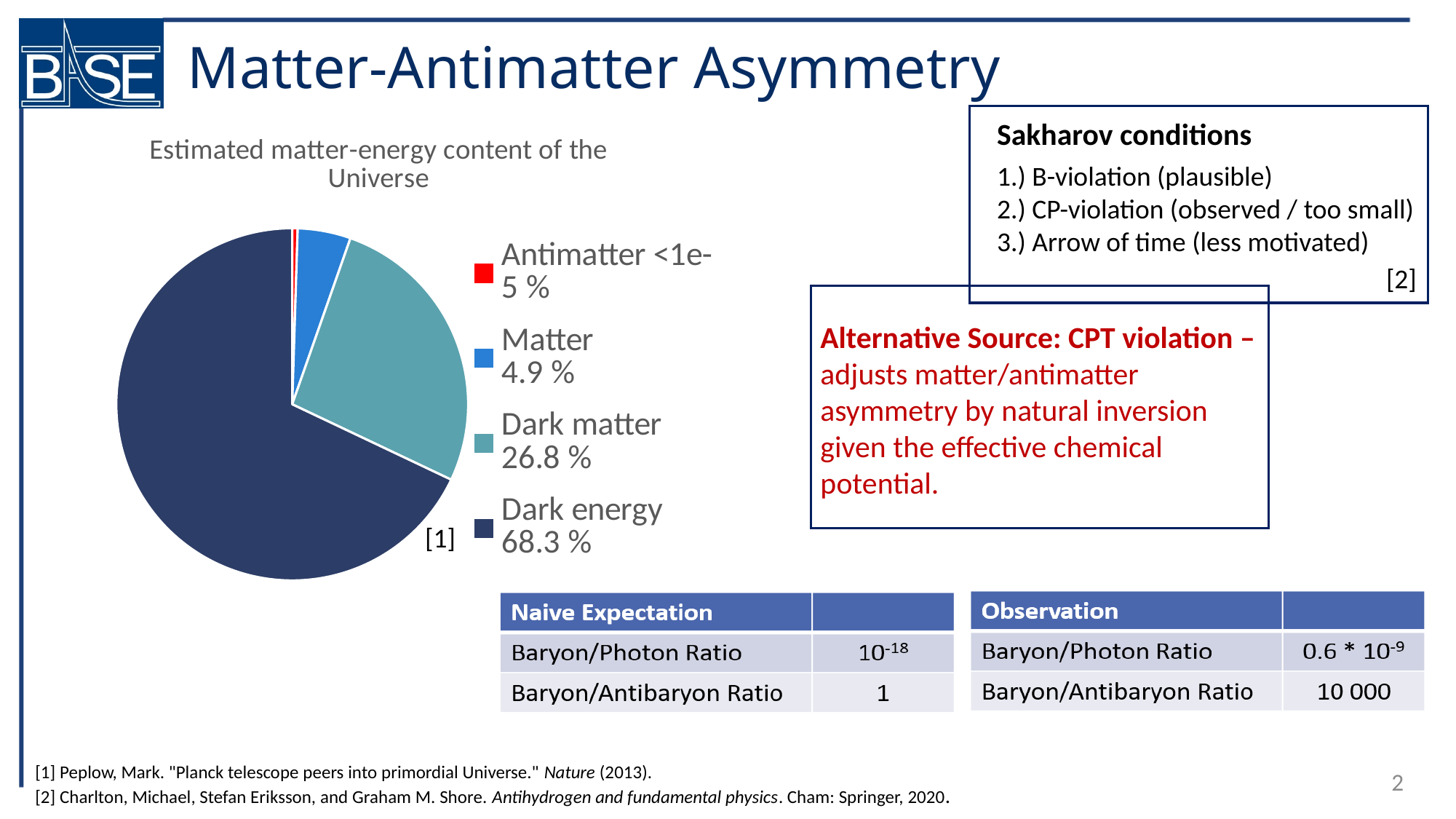
What is the title of the pie chart? Estimated matter-energy content of the Universe What is the difference in percentage points between dark energy and dark matter in the pie chart? 41.5 What percentage of the Universe's matter-energy content is dark energy according to the pie chart? 68.3 % Which category has the largest share of the pie chart? Dark energy What colour represents dark energy in the pie chart? dark navy blue How many categories does the pie chart legend list? 4 Which category has the smallest share of the pie chart? Antimatter What percentage does the pie chart give for matter? 4.9 % What value does the pie chart legend give for antimatter? <1e-5 % What percentage does the pie chart give for dark matter? 26.8 % Which is larger in the pie chart, the share for matter or the share for dark matter? Dark matter What type of chart is shown on the slide? pie chart